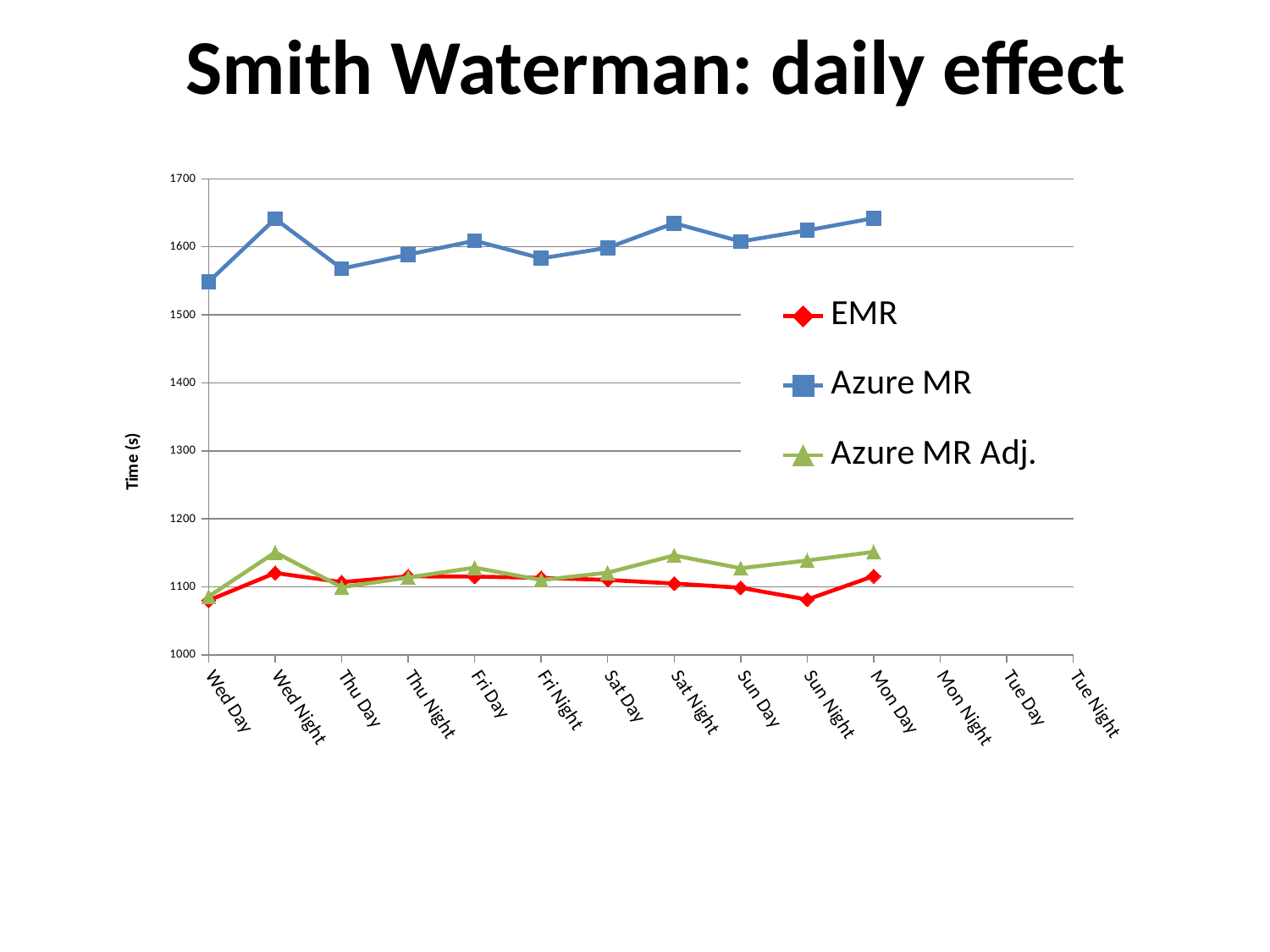
For which category is the Azure MR value lowest? Wed Day Is the Azure MR value for Wed Night greater or less than 1600? greater Which series has the larger value at Sat Night, EMR or Azure MR Adj.? Azure MR Adj. What is the title of the chart? Smith Waterman: daily effect Is the Azure MR Adj. value for Wed Night greater or less than 1100? greater How many category labels are shown on the x axis? 14 What is the label of the y axis? Time (s) Does the Azure MR value rise or fall from Wed Day to Wed Night? rise Is the Azure MR value for Wed Day greater or less than 1600? less How many series does the legend list? 3 What kind of chart is shown on the slide? line chart